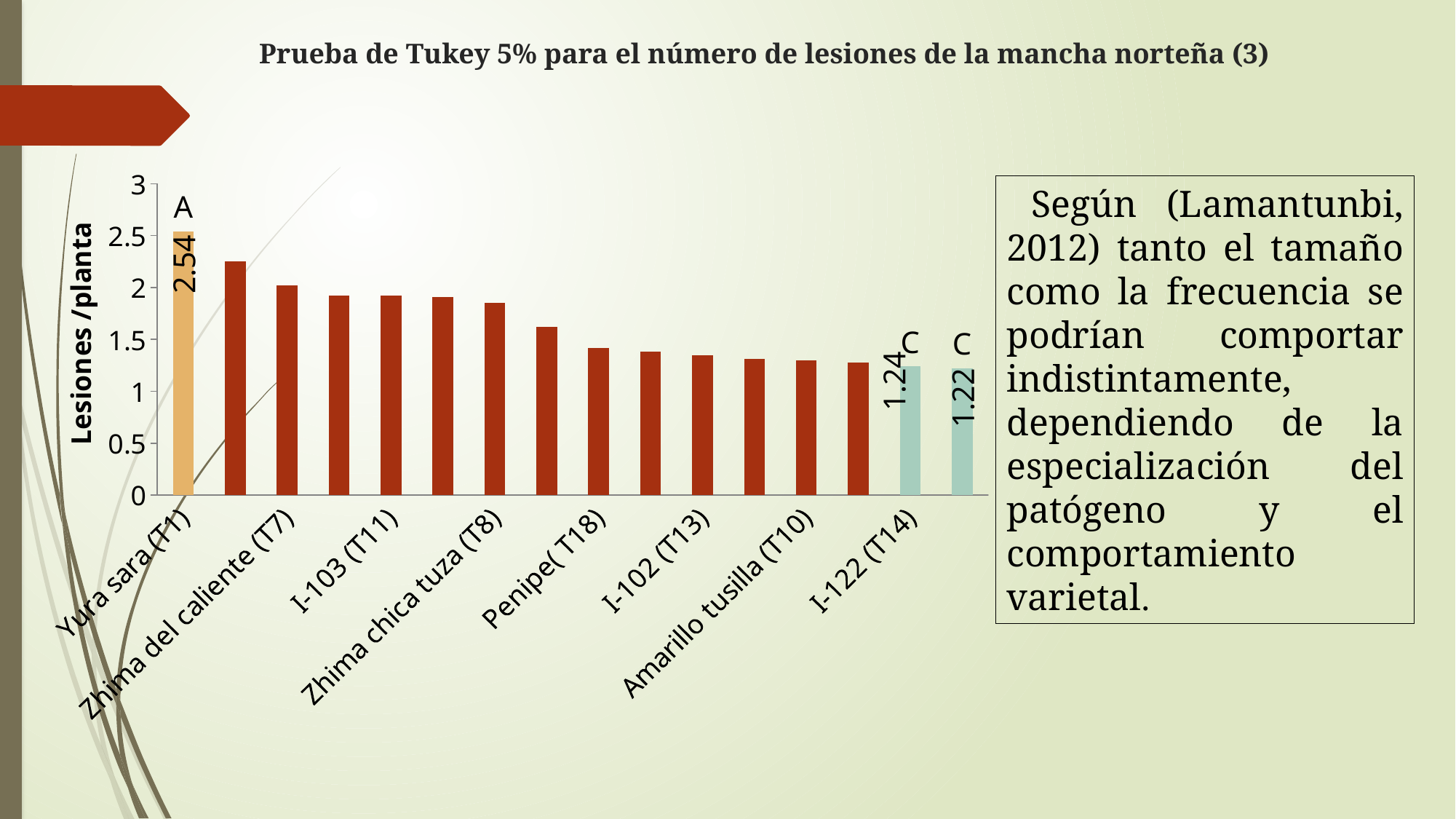
Do the values rise or fall from left to right along the x axis? fall How many bars are plotted in the chart? 16 What is the value for I-122 (T14)? 1.24 Which is larger, the value for Zhima del caliente (T7) or the value for Penipe (T18)? Zhima del caliente (T7) What is the difference between the values for Yura sara (T1) and I-122 (T14)? 1.30 Is the value for Zhima chica tuza (T8) greater or less than 1.5? greater What kind of chart is shown on the slide? bar chart What is the value for Yura sara (T1)? 2.54 Is the value for I-102 (T13) greater or less than 1.5? less What is the title of the y axis? Lesiones /planta Which category has the highest number of lesions per plant? Yura sara (T1)